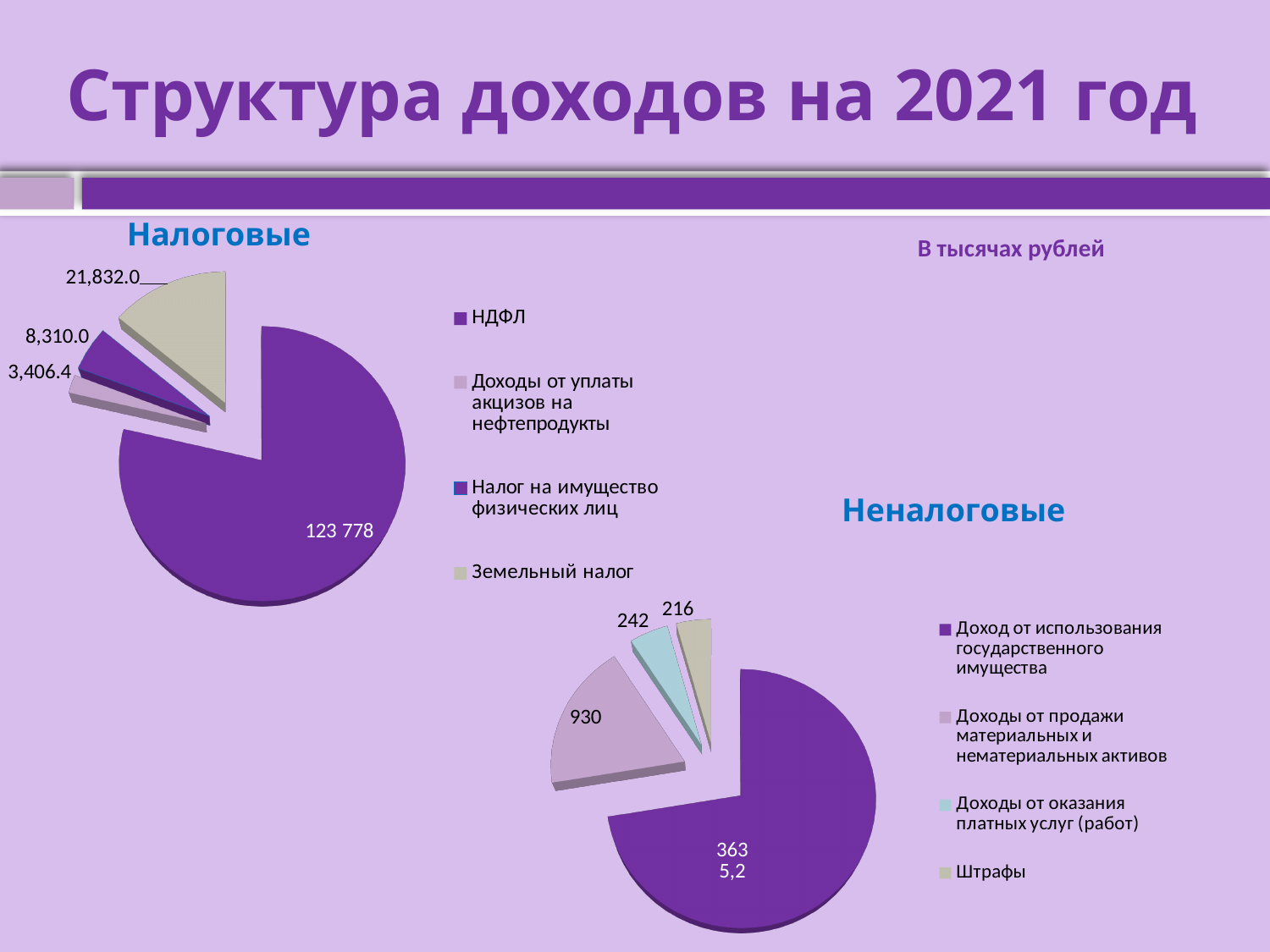
In the "Неналоговые" chart, which is larger: Доходы от оказания платных услуг (работ) or Штрафы? Доходы от оказания платных услуг (работ) How many categories does the "Налоговые" pie chart show? 4 In the "Налоговые" chart, what is the value for Земельный налог? 21,832.0 In the "Налоговые" chart, which category has the smallest value? Доходы от уплаты акцизов на нефтепродукты In the "Неналоговые" chart, which category has the largest value? Доход от использования государственного имущества In the "Неналоговые" chart, what is the value for Штрафы? 216 In the "Неналоговые" chart, what is the value for Доходы от продажи материальных и нематериальных активов? 930 In the "Налоговые" chart, what is the difference between Земельный налог and Налог на имущество физических лиц? 13,522.0 In the "Налоговые" chart, what is the value for НДФЛ? 123 778 What kind of chart is the "Налоговые" chart? pie chart In the "Налоговые" chart, what is the value for Налог на имущество физических лиц? 8,310.0 In what units are the values on the slide given? В тысячах рублей